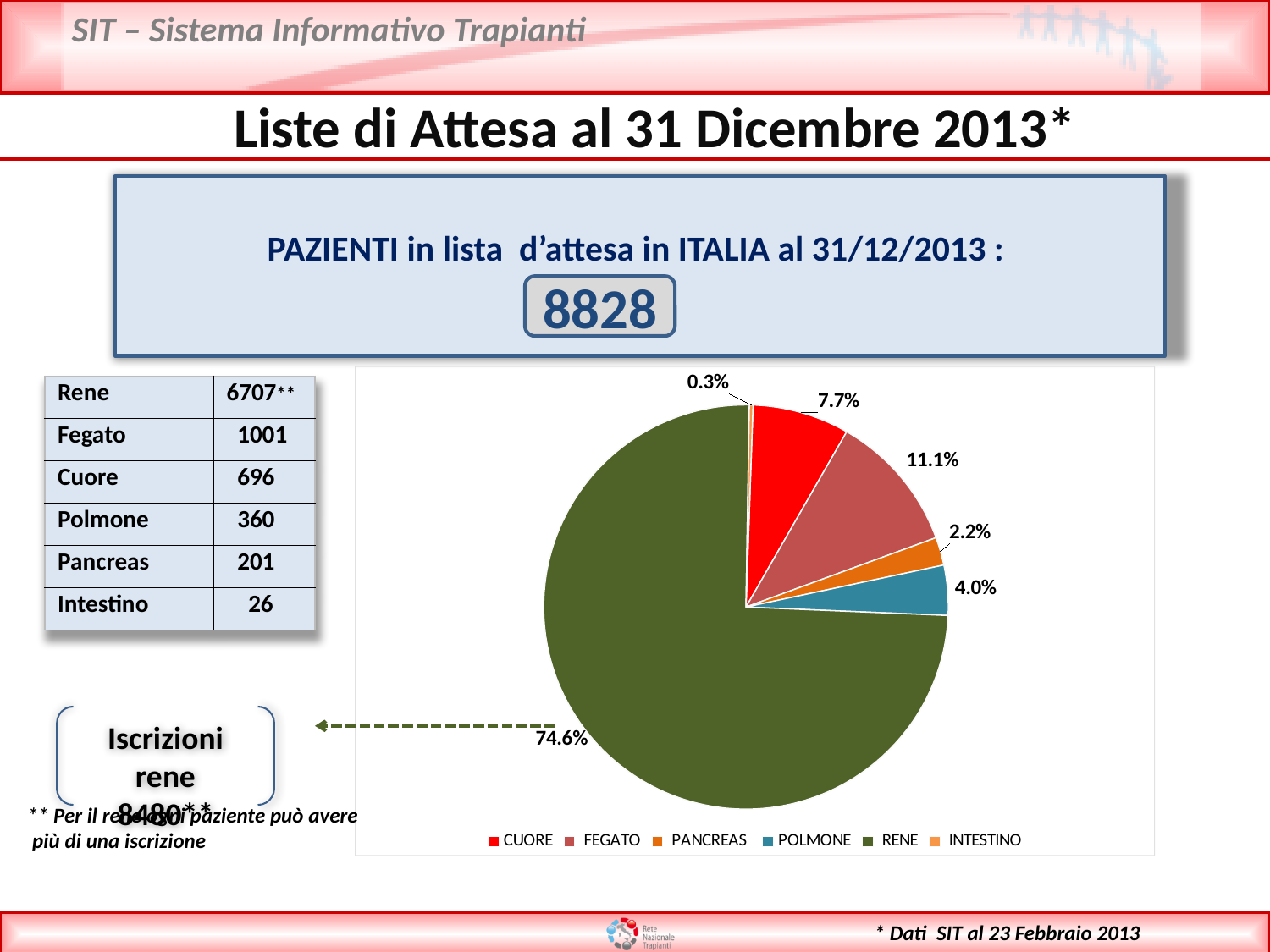
What share of the pie chart does POLMONE represent? 4.0% What share of the pie chart does INTESTINO represent? 0.3% What share of the pie chart does RENE represent? 74.6% Which category has the largest slice in the pie chart? RENE How many categories does the pie chart legend list? 6 What is the difference in percentage points between the FEGATO and CUORE slices? 3.4% Which category has the smallest slice in the pie chart? INTESTINO Which slice is larger in the pie chart, FEGATO or CUORE? FEGATO What kind of chart is shown on the slide? pie chart